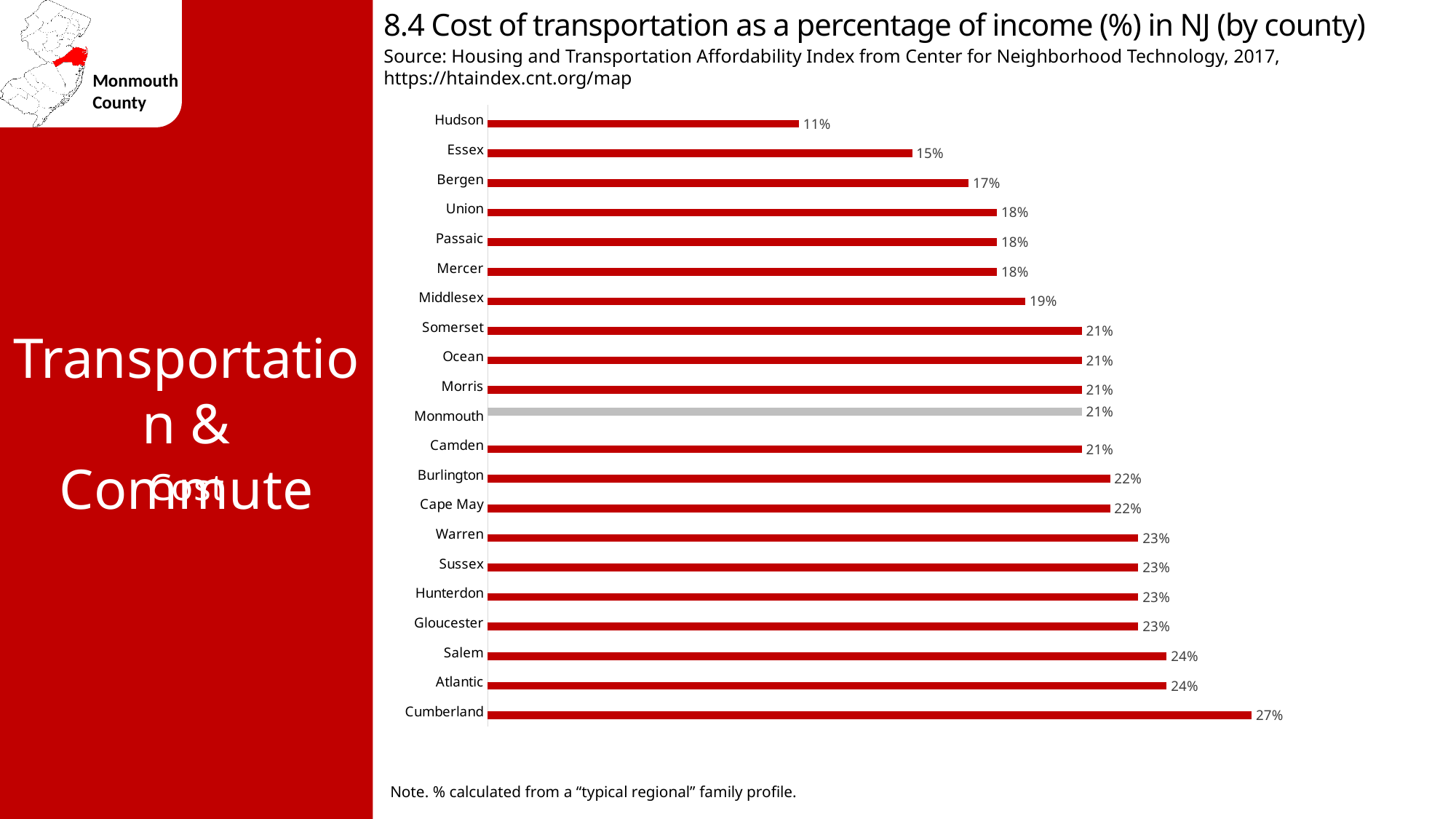
Which county's bar is shown in gray instead of red? Monmouth Which county has the lowest cost of transportation as a percentage of income? Hudson What is the value shown for Middlesex County? 19% What is the value shown for Cumberland County? 27% What is the cost of transportation as a percentage of income for Monmouth County? 21% What is the difference in percentage points between Cumberland and Hudson? 16 How many counties are shown in the chart? 21 What type of chart is used on this slide? Bar chart Which has a higher value, Bergen or Warren? Warren What is the difference in percentage points between Salem and Essex? 9 What is the value shown for Hudson County? 11% Which county has the highest cost of transportation as a percentage of income? Cumberland